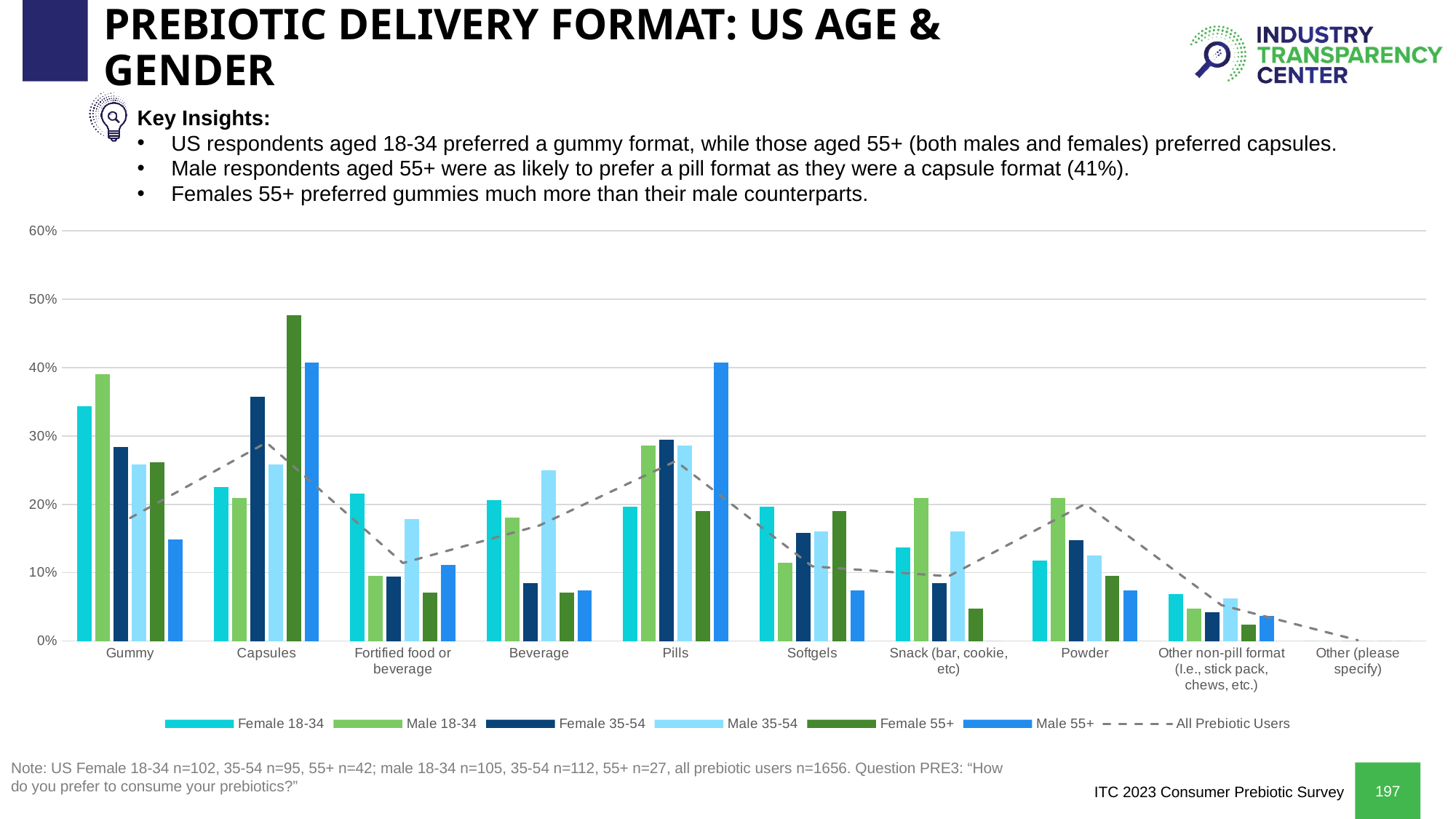
For Gummy, which is larger: the Female 18-34 value or the Male 18-34 value? Male 18-34 Which series is drawn as a dashed line rather than bars? All Prebiotic Users Is the Female 55+ value for Capsules greater or less than 40%? greater How many delivery format categories are shown on the x axis? 10 For the Female 55+ series, which delivery format has the highest value? Capsules For Pills, which is larger: the Female 55+ value or the Male 55+ value? Male 55+ How many series does the legend list? 7 Is the Female 55+ value for Snack (bar, cookie, etc) greater or less than 10%? less Is the Male 35-54 value for Beverage greater or less than 20%? greater What kind of chart is shown on the slide? combination bar and line chart For the Male 18-34 series, which delivery format has the highest value? Gummy For the Female 18-34 series, which delivery format has the highest value? Gummy